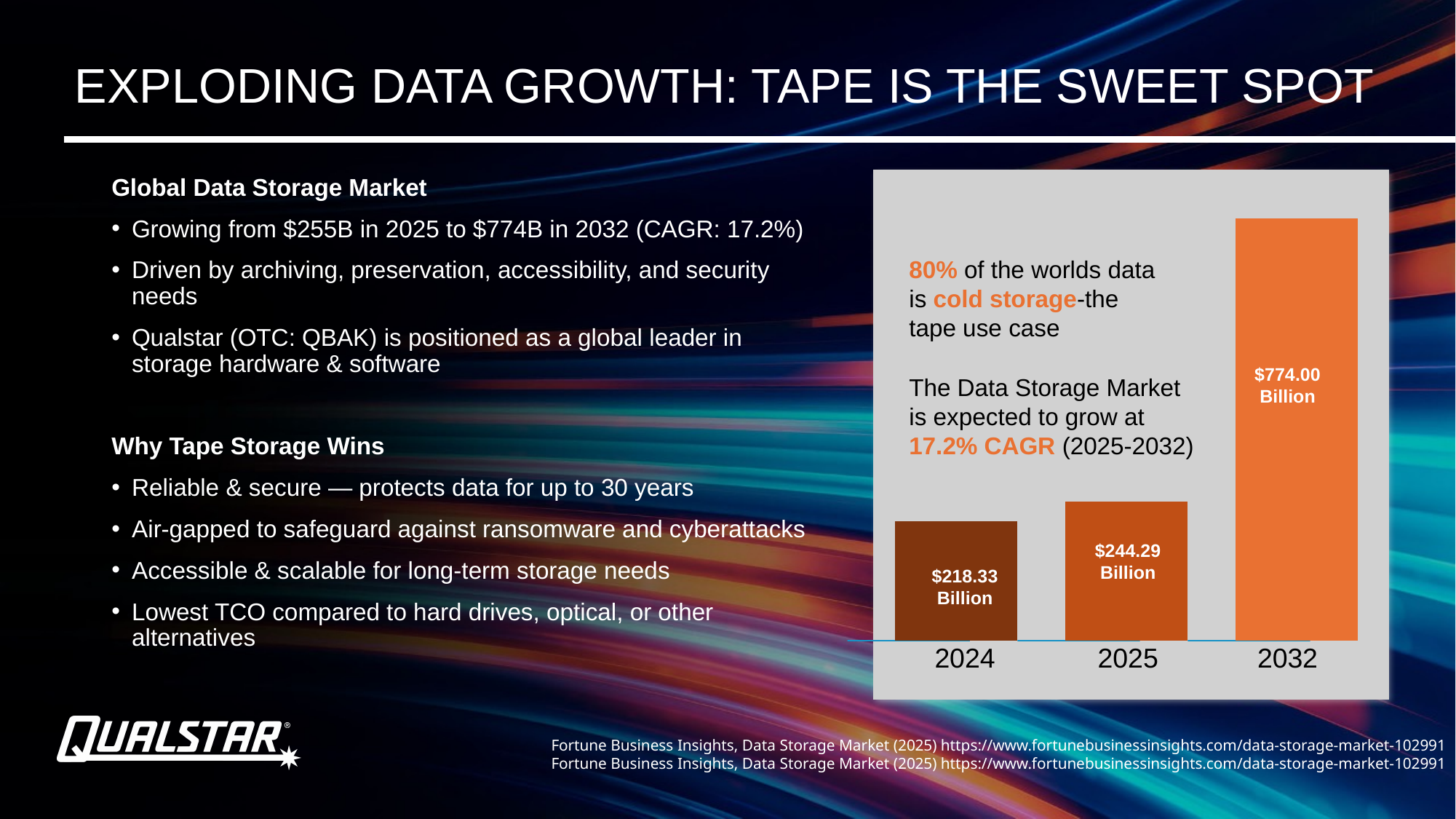
Which year has the highest value in the bar chart? 2032 Which year has the lowest value in the bar chart? 2024 What is the difference between the 2032 value and the 2024 value in the bar chart? $555.67 Billion What is the difference between the 2025 value and the 2024 value in the bar chart? $25.96 Billion What is the value shown for 2025 in the bar chart? $244.29 Billion How many years (bars) are shown in the bar chart? 3 According to the text inside the chart area, what percentage of the world's data is cold storage? 80% What kind of chart is shown on the slide? Bar chart Which is larger in the bar chart, the value for 2025 or the value for 2032? 2032 What is the value shown for 2032 in the bar chart? $774.00 Billion What is the value shown for 2024 in the bar chart? $218.33 Billion Do the values in the bar chart rise or fall from 2024 to 2032? Rise